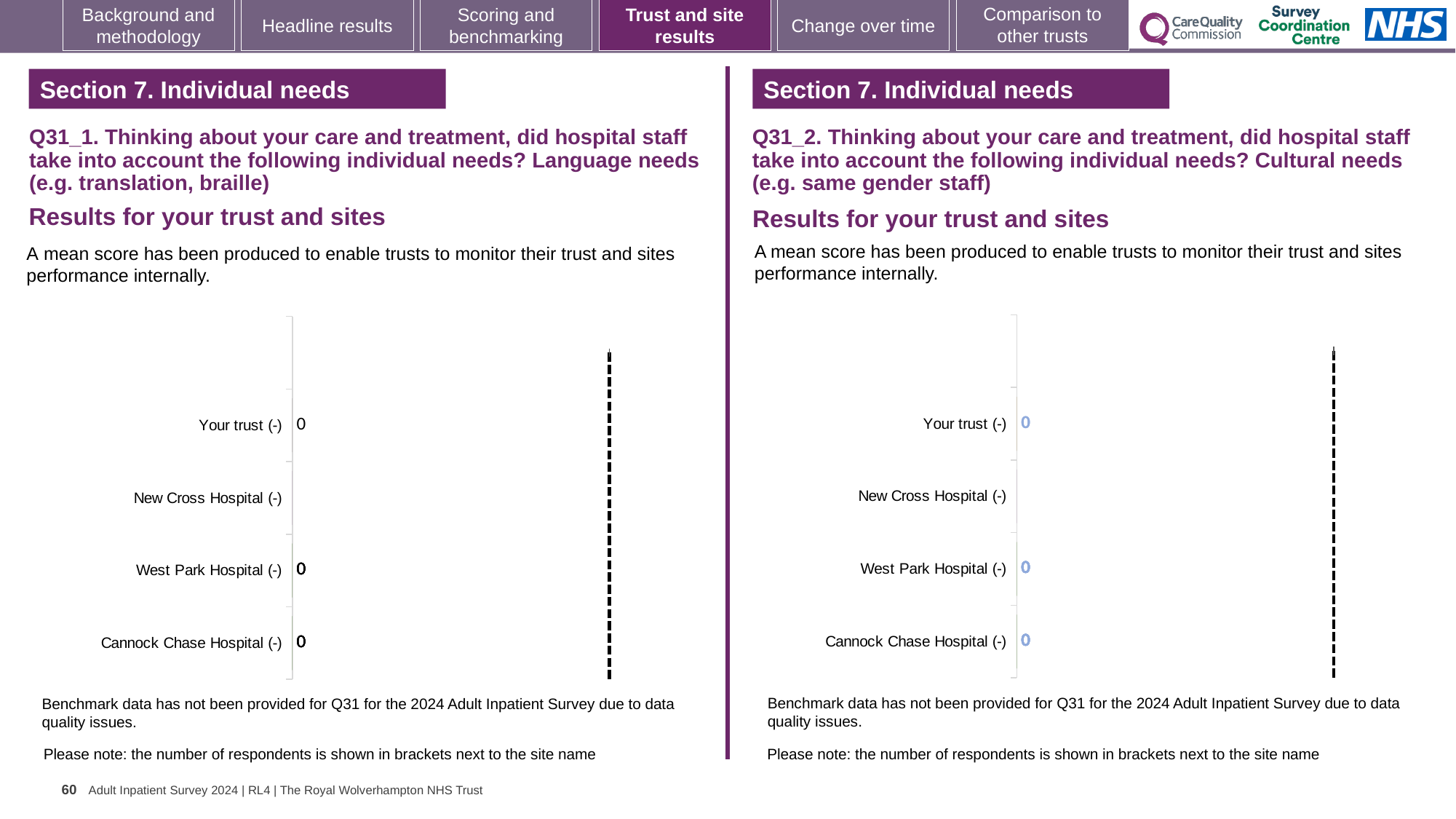
On the right chart (Q31_2, Cultural needs), what value is shown for Cannock Chase Hospital? 0 On the left chart (Q31_1, Language needs), what value is shown for Your trust? 0 On the left chart (Q31_1, Language needs), what is the difference between the values for Your trust and Cannock Chase Hospital? 0 On the right chart (Q31_2, Cultural needs), what value is shown for Your trust? 0 On the right chart (Q31_2, Cultural needs), what value is shown for West Park Hospital? 0 How many categories are listed on the right chart (Q31_2, Cultural needs)? 4 On the left chart (Q31_1, Language needs), what value is shown for West Park Hospital? 0 On the left chart (Q31_1, Language needs), what value is shown for Cannock Chase Hospital? 0 What kind of chart is the left chart (Q31_1, Language needs)? Bar chart Which category is listed first (at the top) on the right chart (Q31_2, Cultural needs)? Your trust (-) How many categories are listed on the left chart (Q31_1, Language needs)? 4 What number is shown in brackets next to each site name on the left chart (Q31_1, Language needs)? -